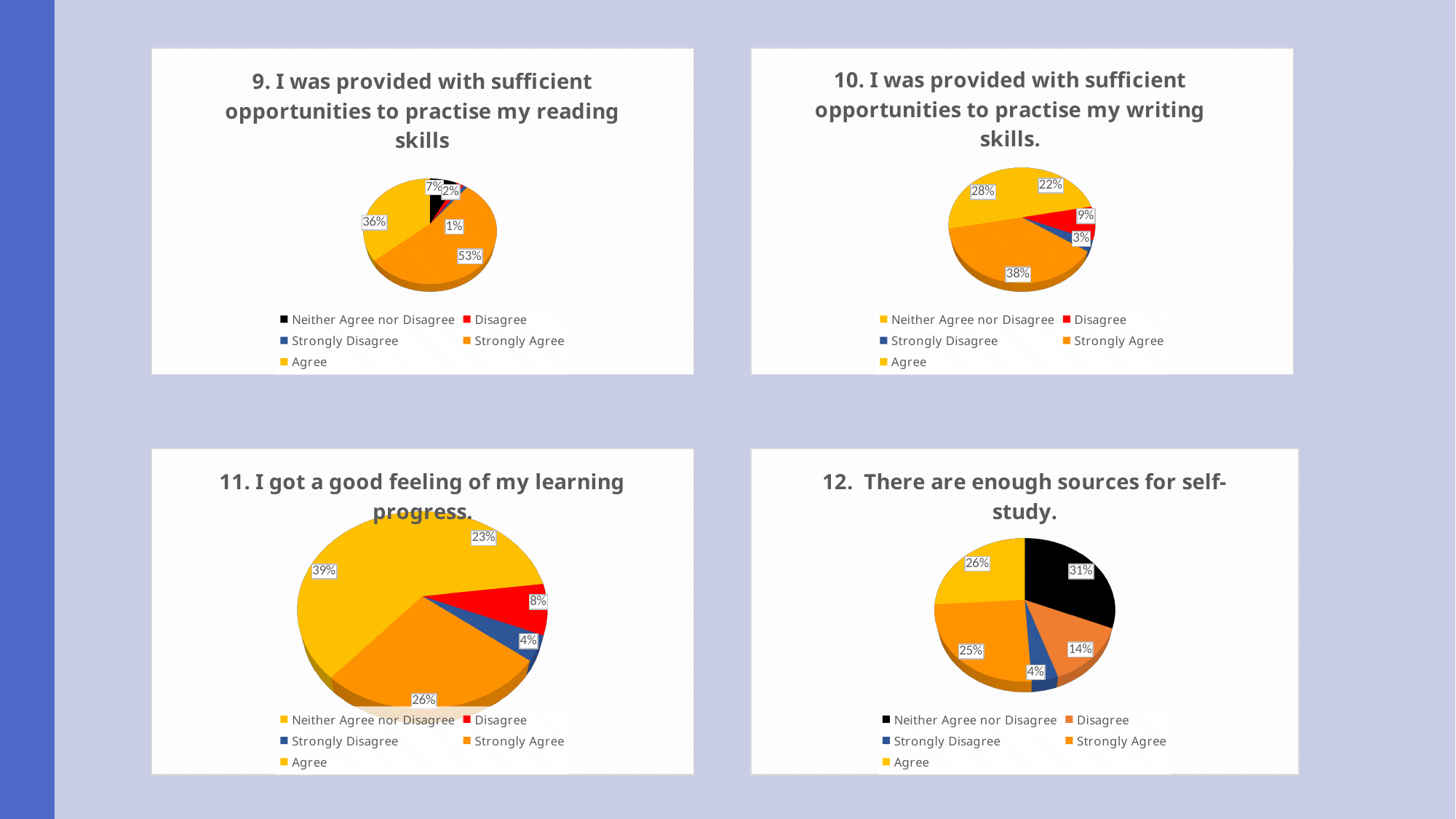
In the chart titled "9. I was provided with sufficient opportunities to practise my reading skills", which response has the largest share? Strongly Agree What type of chart is used in the chart titled "12. There are enough sources for self-study."? Pie chart In the chart titled "12. There are enough sources for self-study.", which response has the largest share? Neither Agree nor Disagree In the chart titled "10. I was provided with sufficient opportunities to practise my writing skills.", what percentage is shown for Strongly Agree? 38% In the chart titled "11. I got a good feeling of my learning progress.", which is larger, Strongly Agree or Strongly Disagree? Strongly Agree In the chart titled "9. I was provided with sufficient opportunities to practise my reading skills", which response has the smallest share? Strongly Disagree In the chart titled "11. I got a good feeling of my learning progress.", what percentage is shown for Disagree? 8% In the chart titled "10. I was provided with sufficient opportunities to practise my writing skills.", what percentage is shown for Disagree? 9% In the chart titled "12. There are enough sources for self-study.", what percentage is shown for Strongly Disagree? 4% In the chart titled "9. I was provided with sufficient opportunities to practise my reading skills", what percentage is shown for Strongly Agree? 53% In the chart titled "9. I was provided with sufficient opportunities to practise my reading skills", what is the difference between the Strongly Agree and Agree percentages? 17% In the chart titled "12. There are enough sources for self-study.", what percentage is shown for Neither Agree nor Disagree? 31%